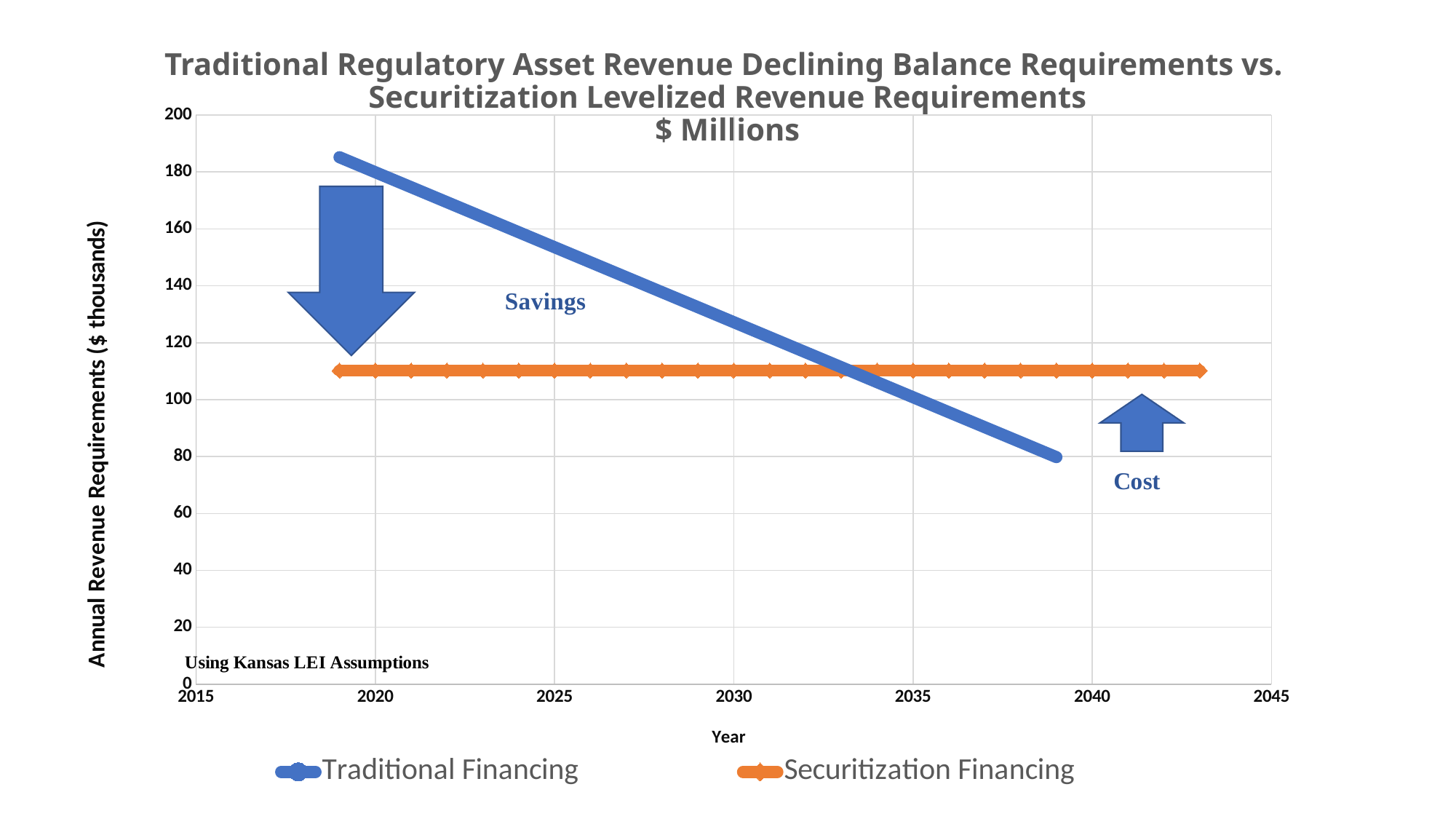
Is the value for Traditional Financing in 2039 greater or less than 100? less Does the Traditional Financing line rise or fall as the year increases? fall In 2025, which series has the higher value, Traditional Financing or Securitization Financing? Traditional Financing Is the value for Securitization Financing in 2040 greater or less than 120? less Does the Securitization Financing line rise, fall, or stay flat as the year increases? stay flat How many series does the legend list? 2 What kind of chart is shown on the slide? line chart In 2038, which series has the higher value, Traditional Financing or Securitization Financing? Securitization Financing Is the value for Securitization Financing in 2025 greater or less than 100? greater What is the title of the vertical axis? Annual Revenue Requirements ($ thousands)